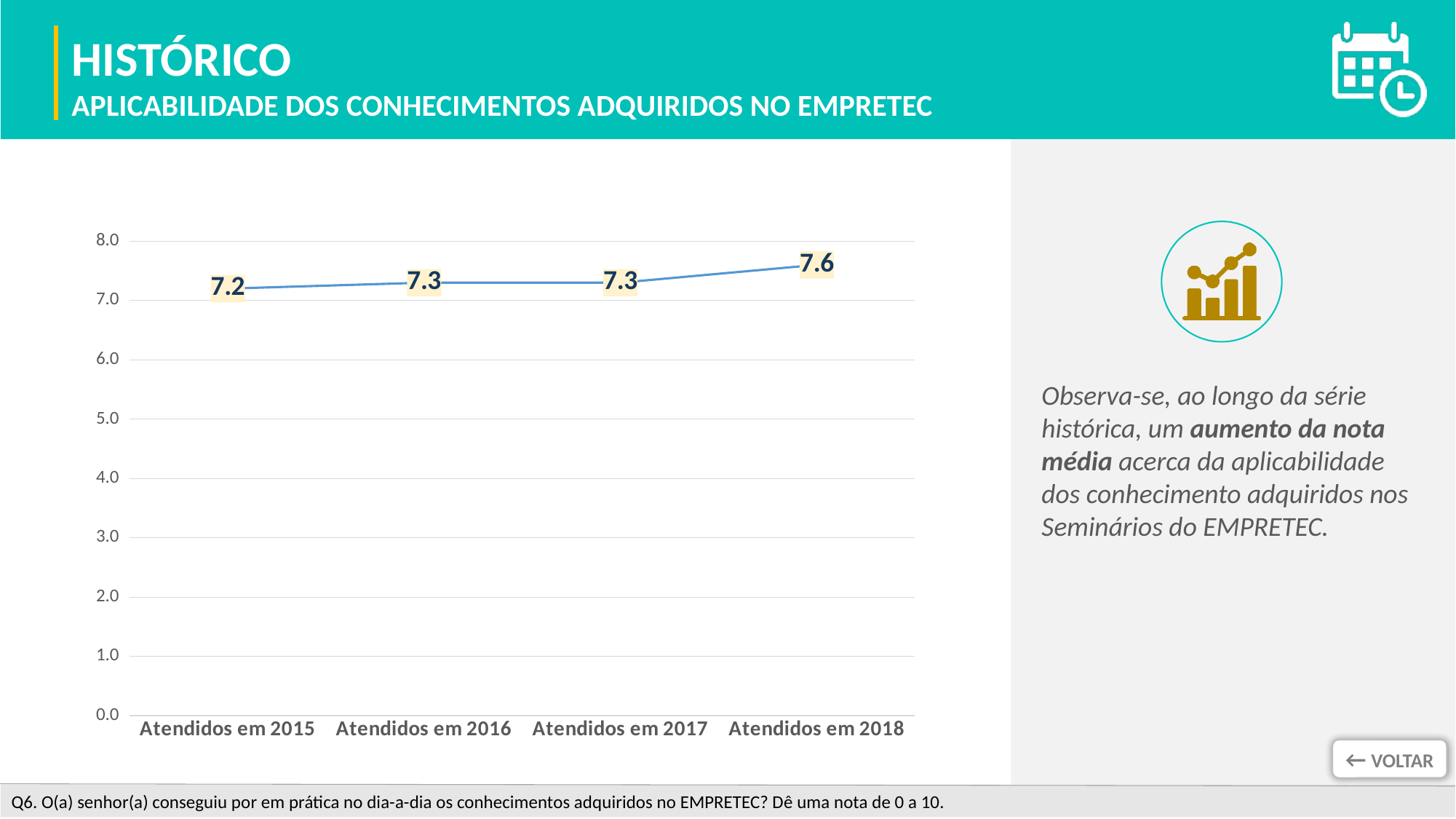
How many categories are shown on the x axis? 4 Which category has the highest value? Atendidos em 2018 What is the value for Atendidos em 2017? 7.3 What is the value for Atendidos em 2015? 7.2 What is the value for Atendidos em 2018? 7.6 What kind of chart is shown on the slide? line chart Which category has the lowest value? Atendidos em 2015 Do the values rise or fall from Atendidos em 2015 to Atendidos em 2018? rise What is the difference between the values for Atendidos em 2018 and Atendidos em 2015? 0.4 Which is larger, the value for Atendidos em 2016 or Atendidos em 2018? Atendidos em 2018 What is the maximum value shown on the y axis? 8.0 Is the value for Atendidos em 2018 greater or less than 7.0? greater